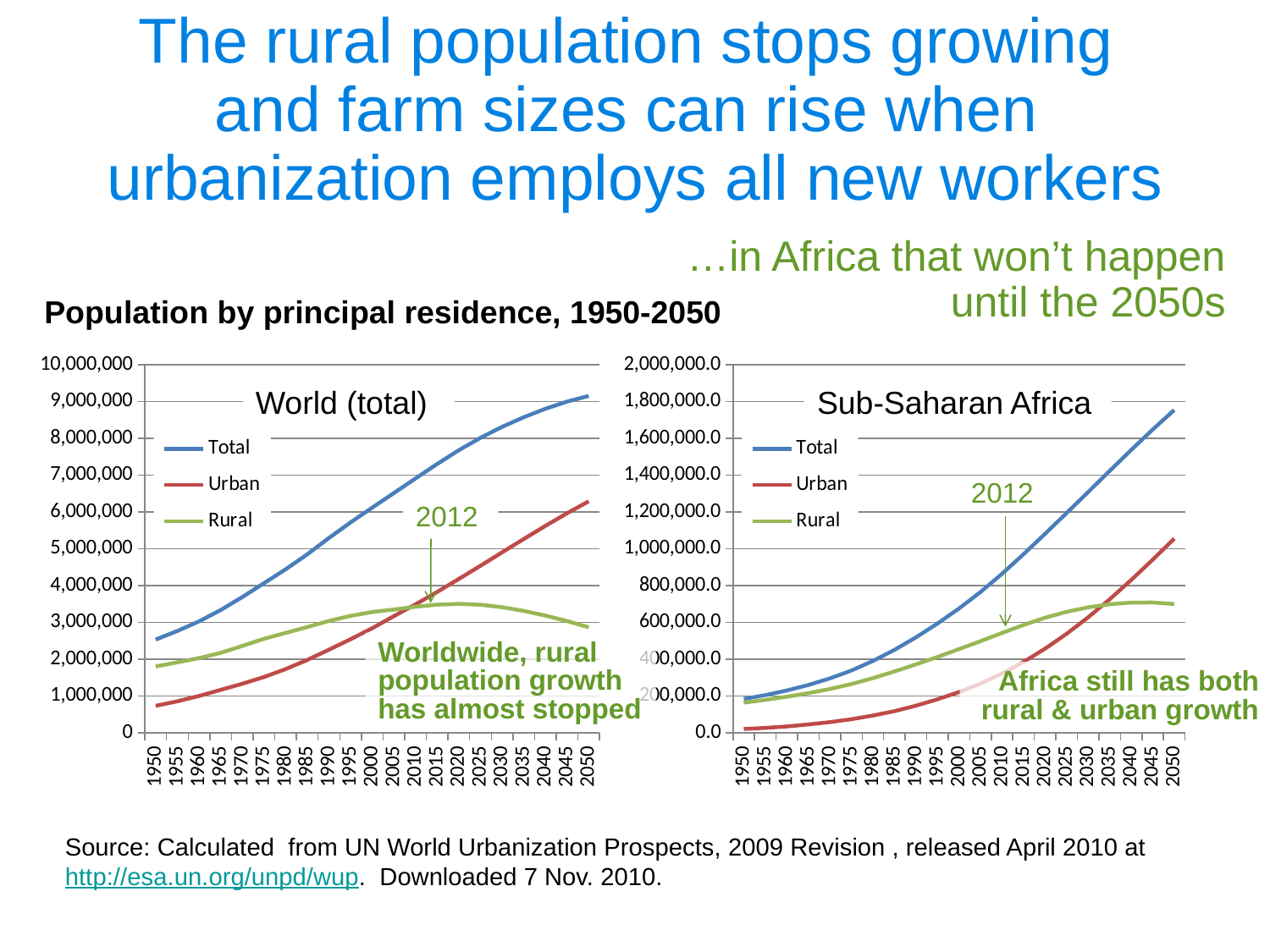
In the World (total) chart, which is larger in 2050, Urban or Rural? Urban In the World (total) chart, how many year points are shown on the x axis? 21 In the Sub-Saharan Africa chart, is the Rural value for 2050 greater or less than 600,000.0? greater What is the title printed above the two charts? Population by principal residence, 1950-2050 In the Sub-Saharan Africa chart, is the Total value for 2050 greater or less than 1,600,000.0? greater In the Sub-Saharan Africa chart, which is larger in 1950, Urban or Rural? Rural In the World (total) chart, is the Total value for 2050 greater or less than 8,000,000? greater What kind of chart is the World (total) chart? line chart In the World (total) chart, does the Rural line rise or fall between 2025 and 2050? fall In the World (total) chart, which series has the highest values throughout? Total How many series does the legend of the Sub-Saharan Africa chart list? 3